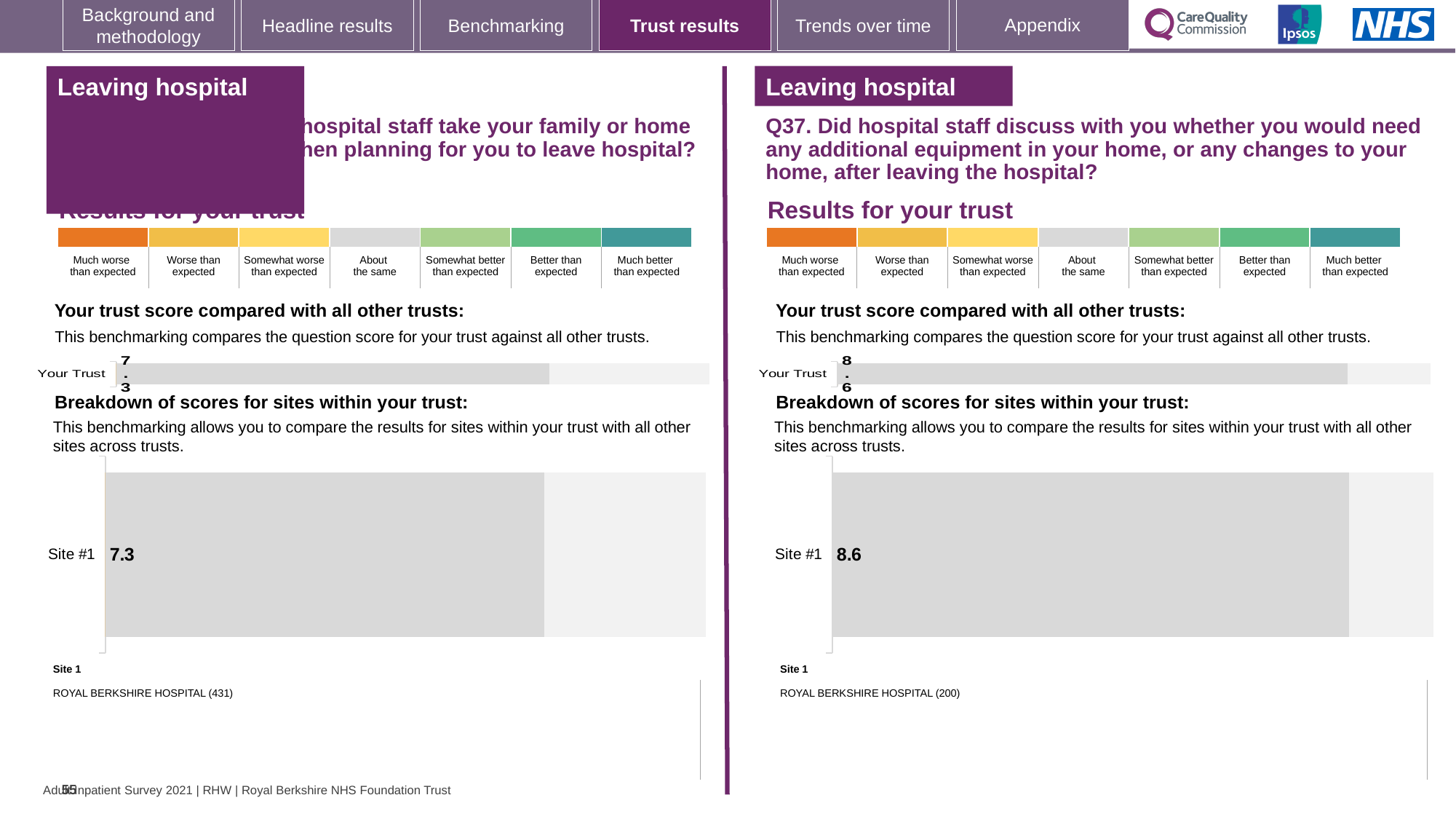
What kind of chart is used to show the Site #1 score on the left panel's 'Breakdown of scores for sites within your trust' section? Bar chart Which hospital is listed as Site 1 on the left panel? ROYAL BERKSHIRE HOSPITAL (431) On the right panel's (Q37) 'Your trust score compared with all other trusts' chart, what is the value for Your Trust? 8.6 How many sites are shown in the left panel's 'Breakdown of scores for sites within your trust' chart? 1 Which hospital is listed as Site 1 on the right panel (Q37)? ROYAL BERKSHIRE HOSPITAL (200) On the right panel's (Q37) 'Breakdown of scores for sites within your trust' chart, what is the value for Site #1? 8.6 On the left panel's 'Your trust score compared with all other trusts' chart, what is the value for Your Trust? 7.3 Which is larger: the Your Trust score on the left panel or the Your Trust score on the right panel (Q37)? Right panel (Q37) How many sites are shown in the right panel's (Q37) 'Breakdown of scores for sites within your trust' chart? 1 On the left panel's 'Breakdown of scores for sites within your trust' chart, what is the value for Site #1? 7.3 What is the difference between the Site #1 score on the right panel (Q37) and the Site #1 score on the left panel? 1.3